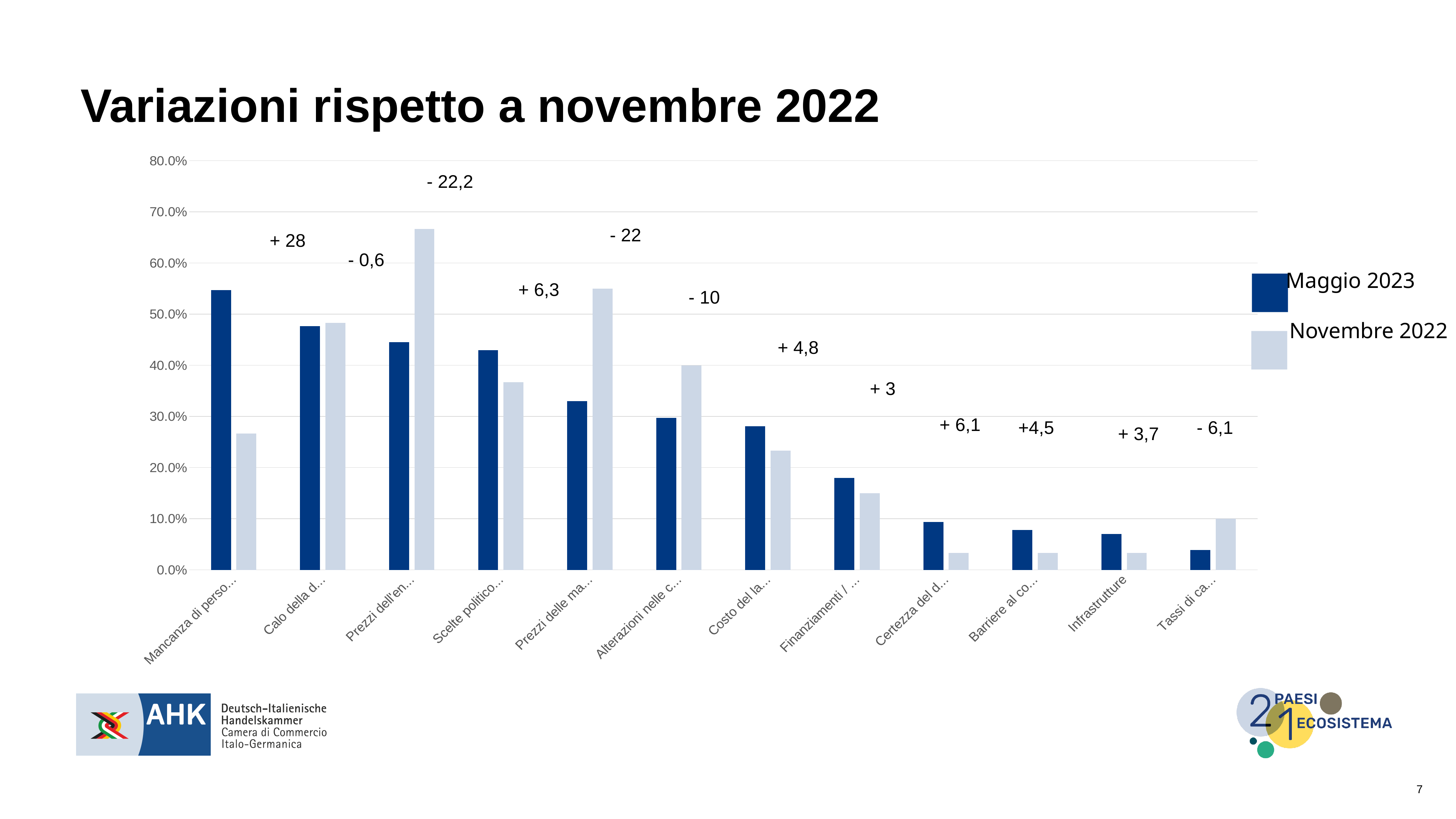
How many categories are plotted along the x axis? 12 What change is annotated above the Infrastrutture category? + 3,7 Which series contains the tallest bar in the chart? Novembre 2022 What are the two series named in the legend? Maggio 2023 and Novembre 2022 Is the Maggio 2023 value for Infrastrutture greater or less than 10.0%? less Is the Maggio 2023 value for the first category from the left greater or less than 50.0%? greater What is the title of the slide? Variazioni rispetto a novembre 2022 Do the Maggio 2023 bars rise or fall from left to right along the x axis? fall For Infrastrutture, which series has the larger value, Maggio 2023 or Novembre 2022? Maggio 2023 Is the Novembre 2022 value for the first category from the left greater or less than 30.0%? less What kind of chart is shown on the slide? bar chart How many series does the legend list? 2